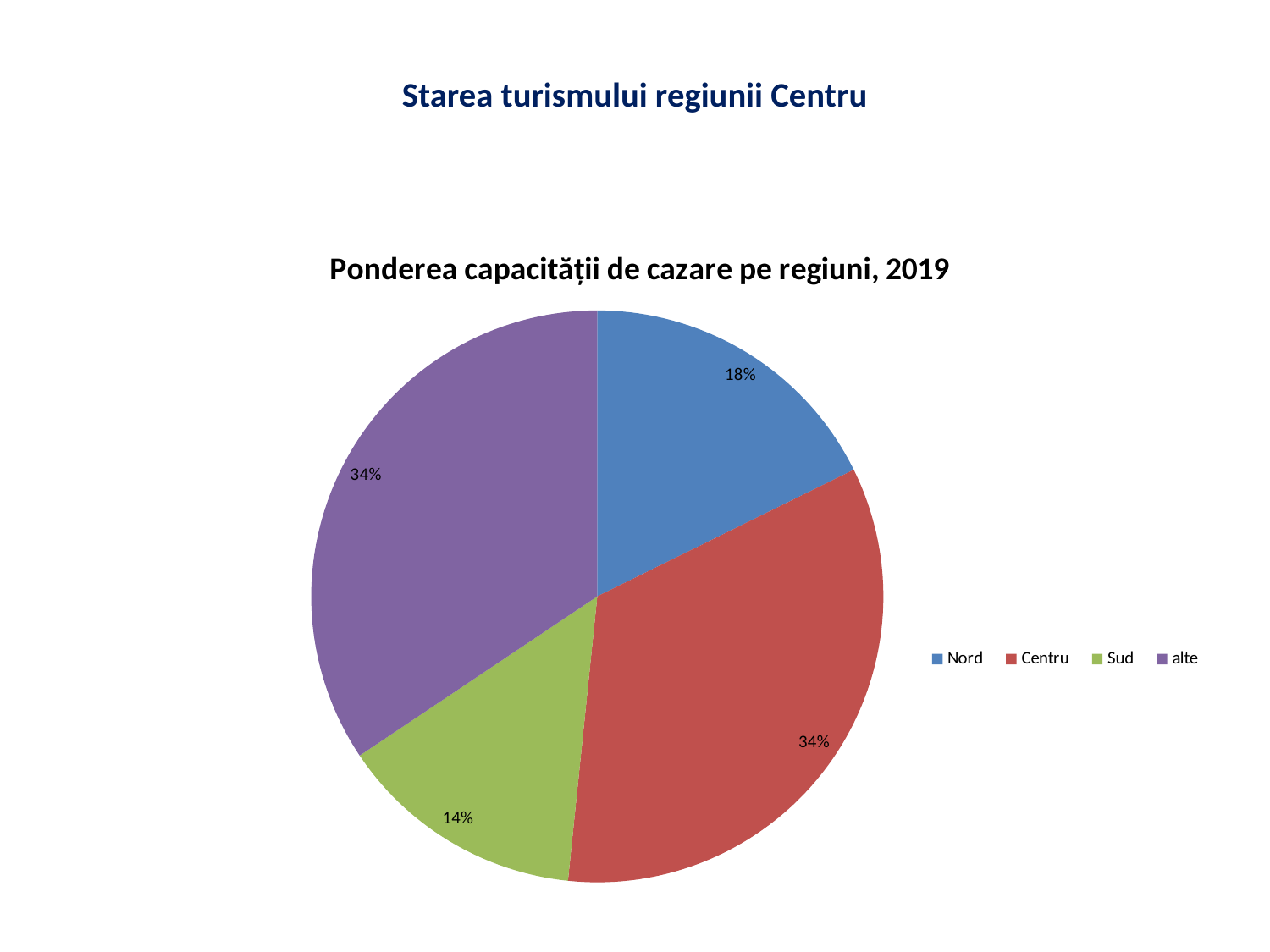
What share of the pie does Sud have? 14% Which category has the smallest slice of the pie? Sud What kind of chart is shown on the slide? Pie chart What is the title of the chart? Ponderea capacității de cazare pe regiuni, 2019 What share of the pie does Centru have? 34% Which slice is larger, Nord or Sud? Nord What share of the pie does Nord have? 18% How many categories does the pie chart show? 4 Which slice is larger, alte or Nord? alte What is the difference in percentage points between the Centru slice and the Nord slice? 16 What share of the pie does alte have? 34% What is the difference in percentage points between the Nord slice and the Sud slice? 4